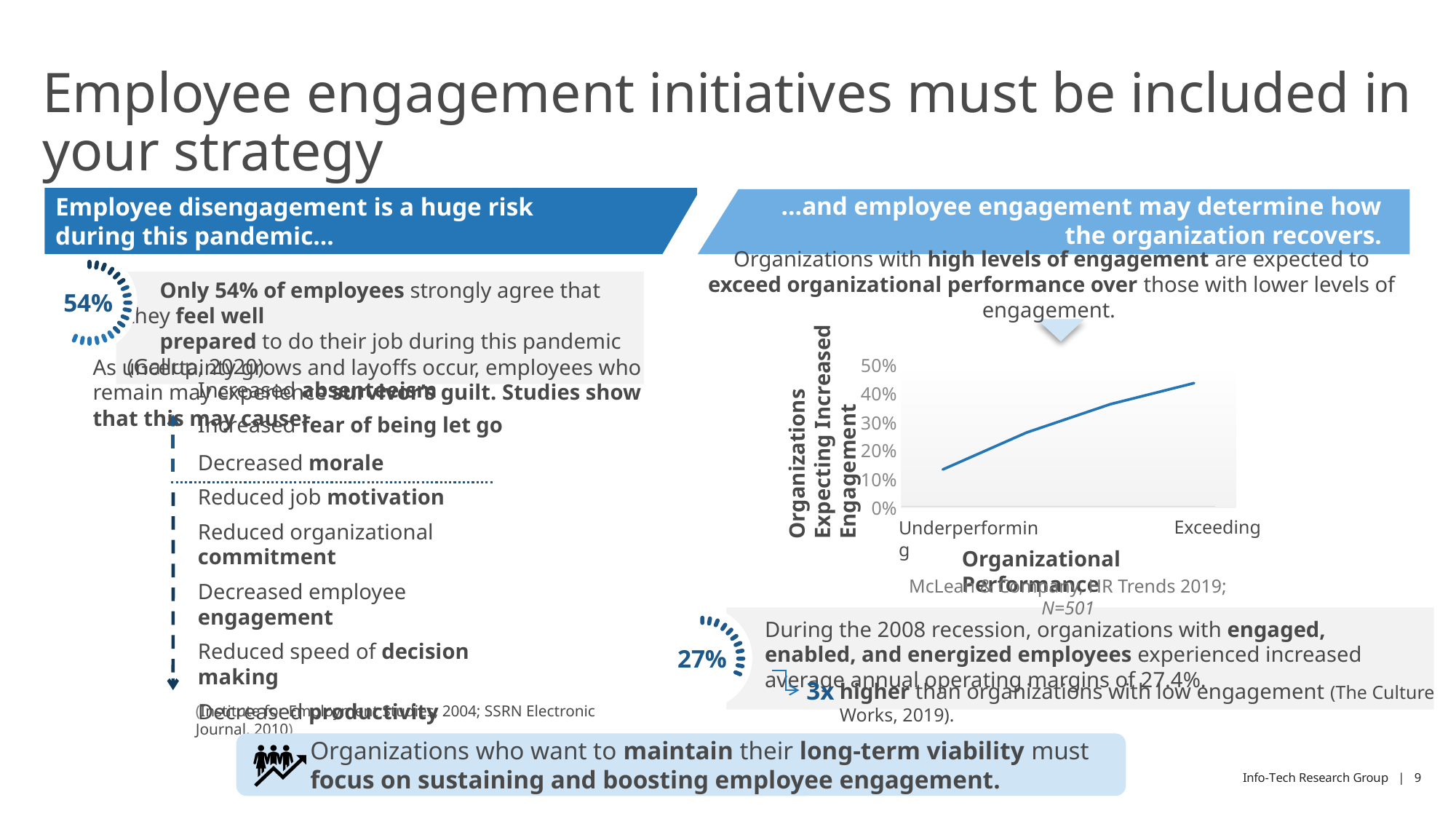
Is the value for Underperforming greater or less than 20%? less What is the title of the chart's y axis? Organizations Expecting Increased Engagement How many category labels are shown on the x axis of the chart? 2 What is the title of the chart's x axis? Organizational Performance Does the line in the chart rise or fall as organizational performance moves from Underperforming to Exceeding? rise Is the value for Exceeding greater or less than 40%? greater What kind of chart is shown on the slide? line chart Is the value for Exceeding greater or less than 50%? less Which x-axis category has the lowest value in the chart? Underperforming Which x-axis category has the highest value in the chart? Exceeding Which has the higher value in the chart, Underperforming or Exceeding? Exceeding